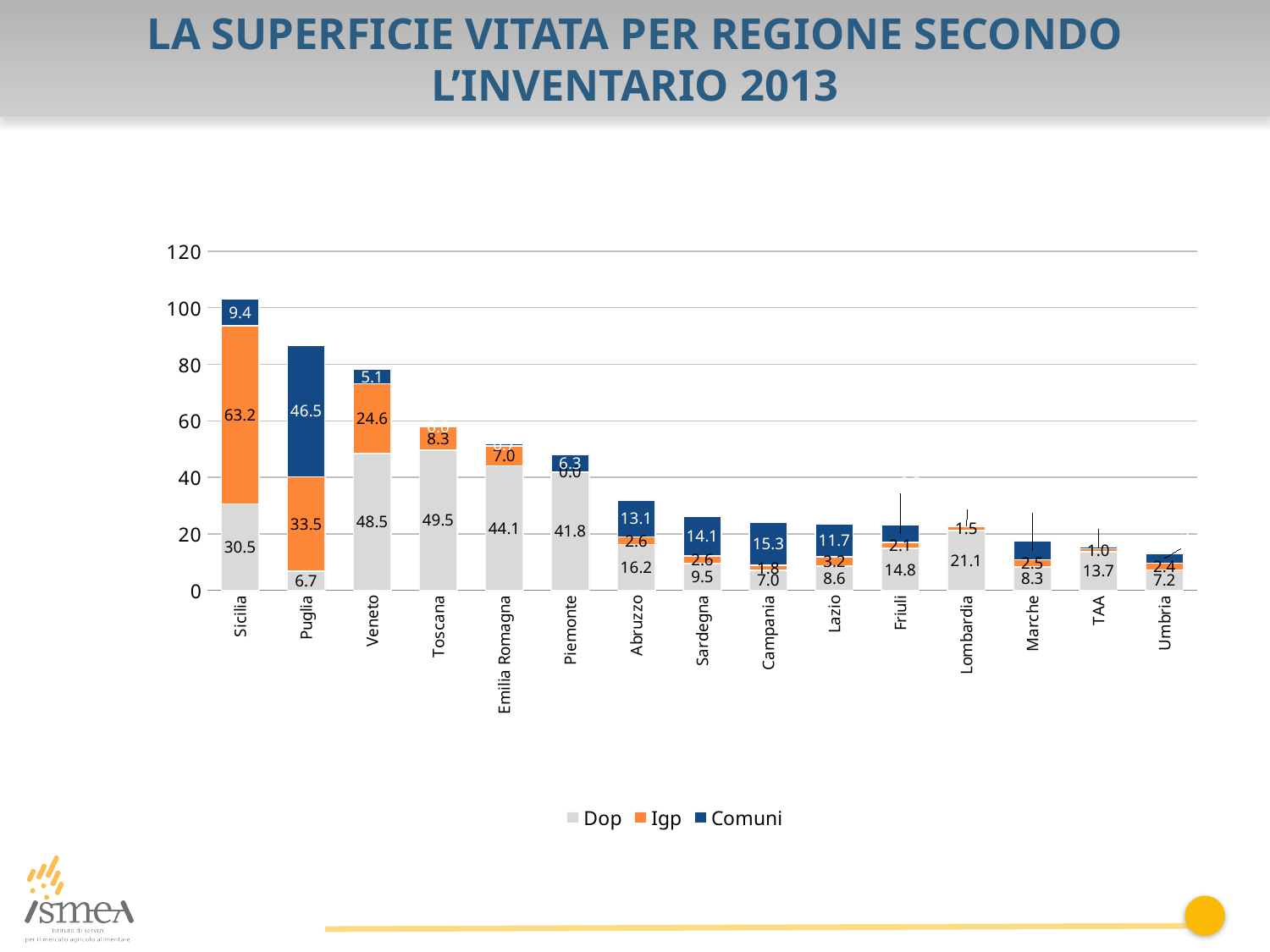
What is the Comuni value for Puglia? 46.5 What is the Igp value for Sicilia? 63.2 Which is larger, the Comuni value for Abruzzo or the Comuni value for Sardegna? Sardegna Is the total height of the Puglia bar greater or less than 80? greater How many regions are shown on the x axis? 15 Which region has the highest Comuni value? Puglia What is the total of the stacked bar for Sicilia? 103.1 How many series does the legend list? 3 Which region has the lowest Dop value? Puglia Which region has the highest Igp value? Sicilia What is the difference between the Igp value for Sicilia and the Igp value for Puglia? 29.7 What is the Dop value for Veneto? 48.5